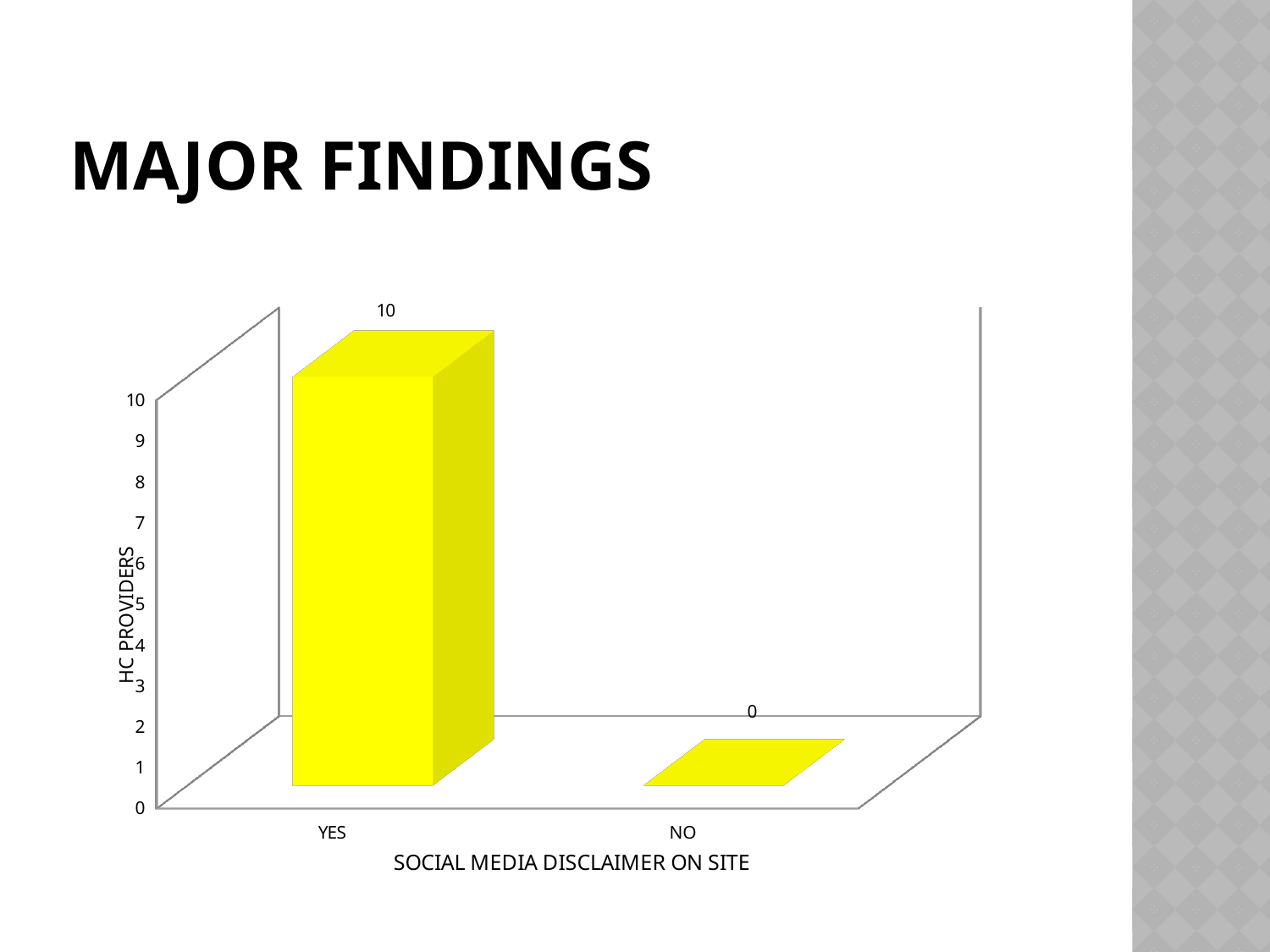
Is the value for YES greater or less than 5? greater What kind of chart is shown on the slide? bar chart What is the total of the values for YES and NO? 10 Which category has the highest value? YES What is the value for YES? 10 What is the difference between the values for YES and NO? 10 What is the label of the horizontal axis? SOCIAL MEDIA DISCLAIMER ON SITE Which is larger, the value for YES or the value for NO? YES How many categories are shown on the x axis? 2 What is the value for NO? 0 Which category has the lowest value? NO What is the label of the vertical axis? HC PROVIDERS